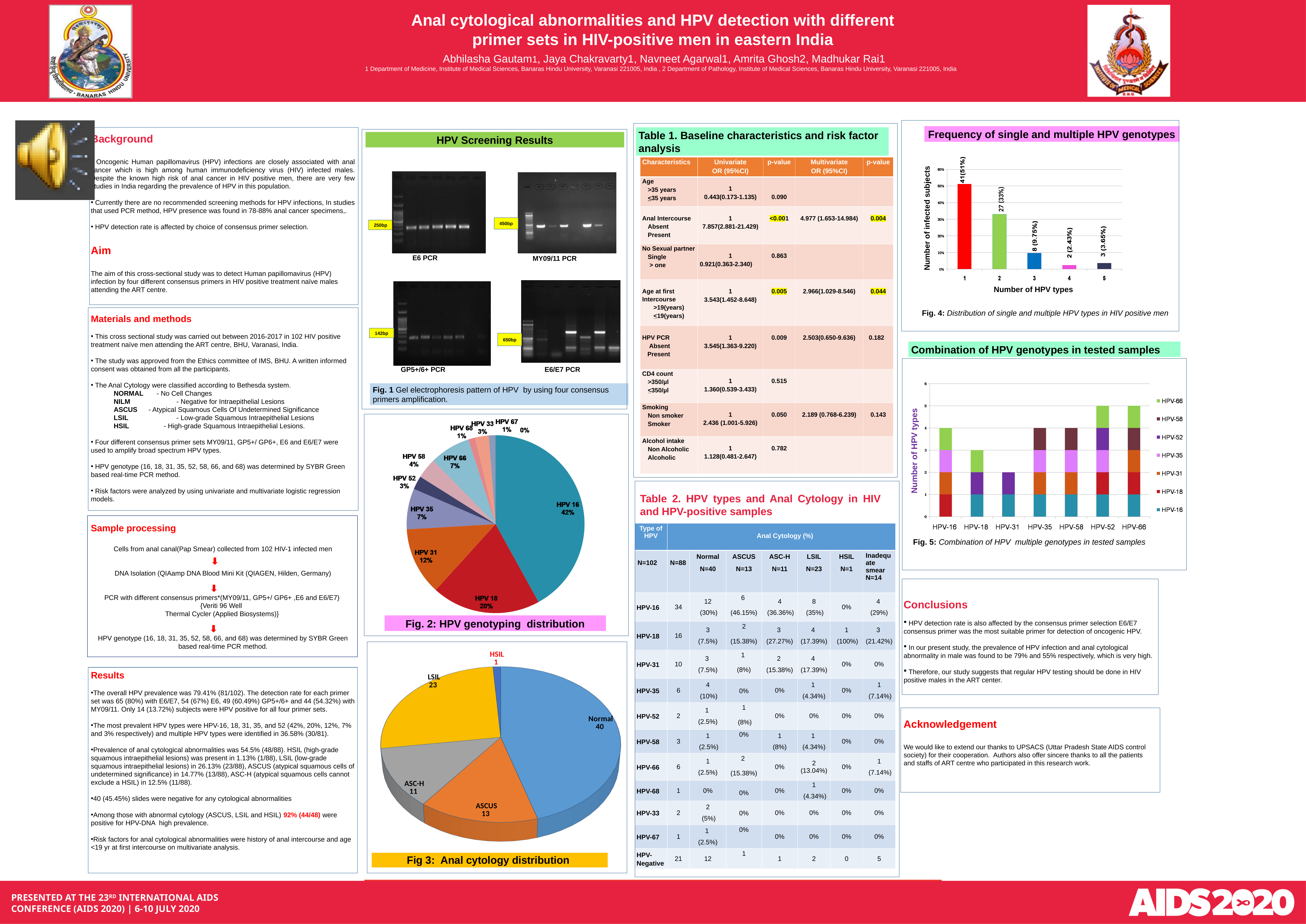
In the Fig. 5 chart 'Combination of HPV genotypes in tested samples', is the total height of the HPV-52 bar greater or less than 4? greater In the Fig. 3 anal cytology distribution chart, what value is shown for LSIL? 23 In the Fig. 5 chart 'Combination of HPV genotypes in tested samples', how many series does the legend list? 7 In the Fig. 4 chart 'Frequency of single and multiple HPV genotypes', how many categories are shown on the x axis? 5 In the Fig. 2 HPV genotyping distribution pie chart, what percentage is shown for HPV 16? 42% In the Fig. 2 HPV genotyping distribution pie chart, what is the difference in percentage between HPV 18 and HPV 31? 8% In the Fig. 4 chart 'Frequency of single and multiple HPV genotypes', do the values generally rise or fall as the number of HPV types increases from 1 to 4? Fall In the Fig. 4 chart 'Frequency of single and multiple HPV genotypes', what is the value labelled for 2 HPV types? 27 (33%) In the Fig. 3 anal cytology distribution chart, which category has the smallest value? HSIL In the Fig. 2 HPV genotyping distribution pie chart, which HPV type has the largest slice? HPV 16 What kind of chart is Fig. 3 (Anal cytology distribution)? Pie chart In the Fig. 2 HPV genotyping distribution pie chart, which is larger, HPV 58 or HPV 52? HPV 58